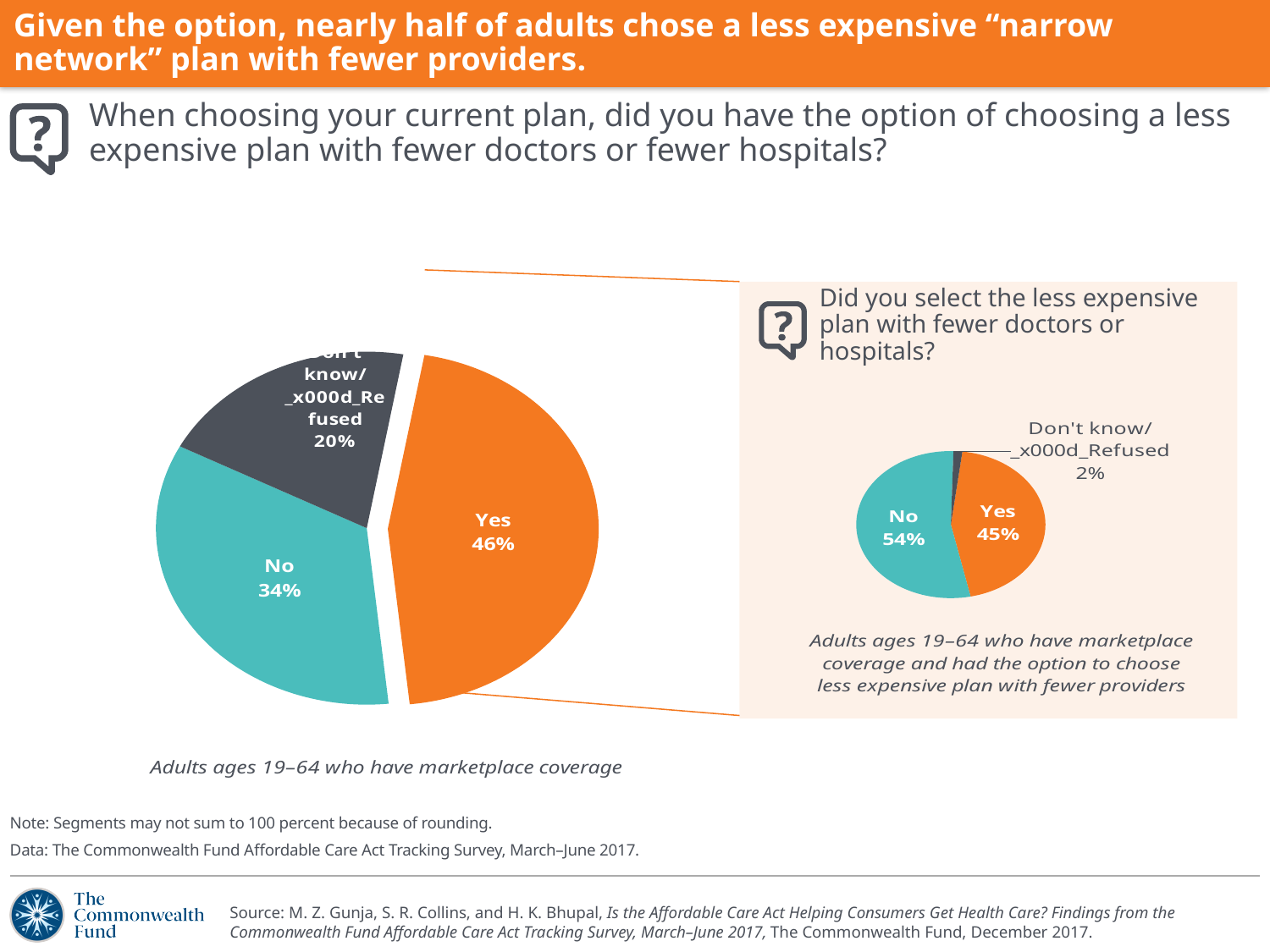
What type of chart is used on the left side of the slide? Pie chart In the large pie chart on the left, what share of adults answered "No"? 34% In the small pie chart on the right, what share of adults answered "No"? 54% In the large pie chart on the left, what share of adults answered "Don't know/Refused"? 20% In the large pie chart on the left, what share of adults answered "Yes"? 46% How many segments does the large pie chart on the left have? 3 In the large pie chart on the left, which response has the largest share? Yes In the large pie chart on the left, what is the difference in percentage points between the "Yes" and "No" shares? 12 percentage points In the small pie chart on the right, what share of adults answered "Don't know/Refused"? 2% In the small pie chart on the right, what share of adults answered "Yes"? 45% In the small pie chart on the right, which response has the smallest share? Don't know/Refused In the small pie chart on the right, which is larger, the "Yes" share or the "No" share? No